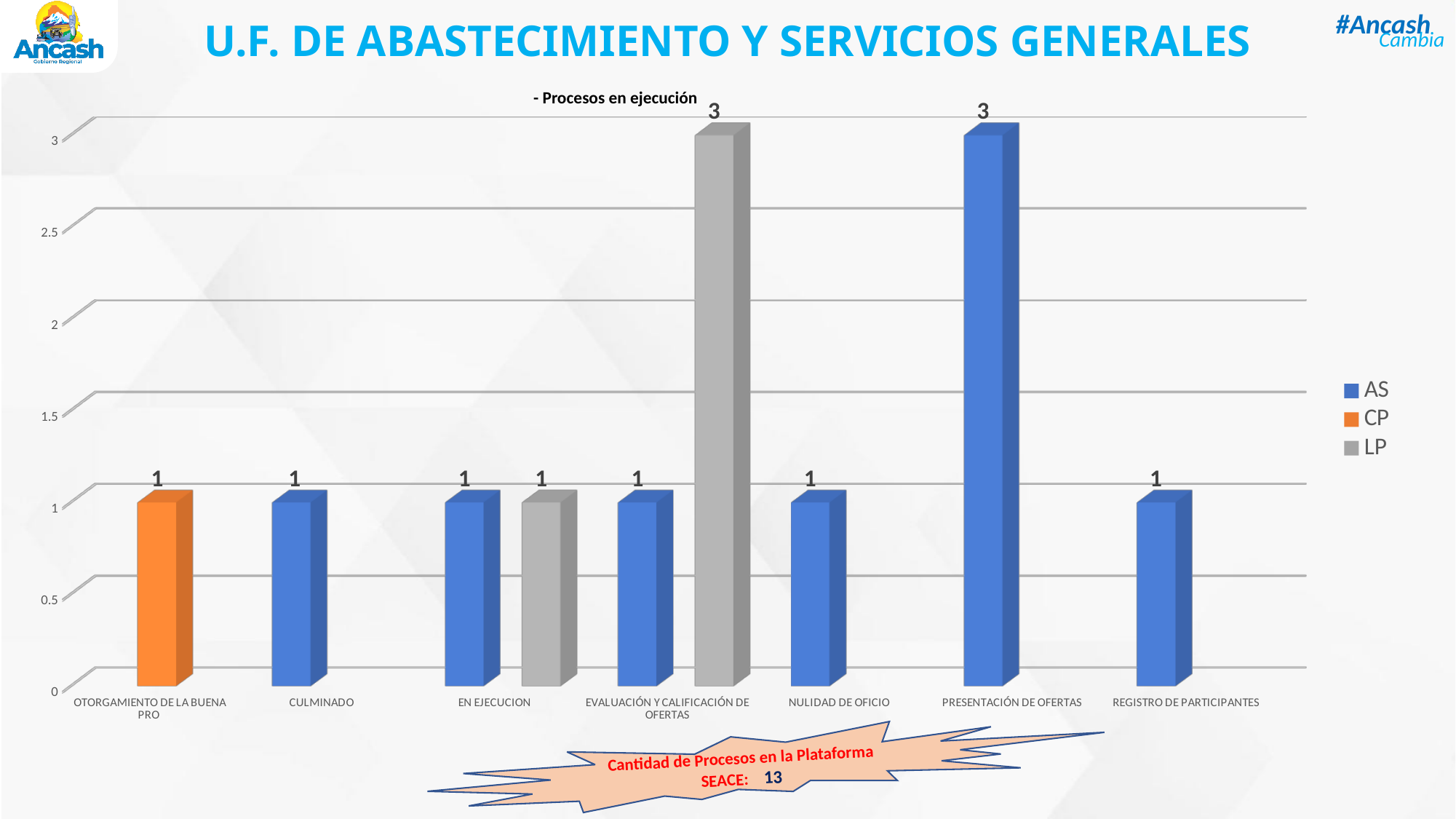
What kind of chart is shown on the slide? Bar chart Which series is shown in orange in the legend? CP What is the value of the AS bar for PRESENTACIÓN DE OFERTAS? 3 How many series does the legend list? 3 What is the title of the chart? - Procesos en ejecución How many categories are shown on the x axis? 7 What is the value of the LP bar for EN EJECUCION? 1 What is the value of the LP bar for EVALUACIÓN Y CALIFICACIÓN DE OFERTAS? 3 Which is larger: the AS value for PRESENTACIÓN DE OFERTAS or the AS value for CULMINADO? PRESENTACIÓN DE OFERTAS What is the value of the CP bar for OTORGAMIENTO DE LA BUENA PRO? 1 What is the difference between the LP value and the AS value for EVALUACIÓN Y CALIFICACIÓN DE OFERTAS? 2 Which category has the highest AS value? PRESENTACIÓN DE OFERTAS